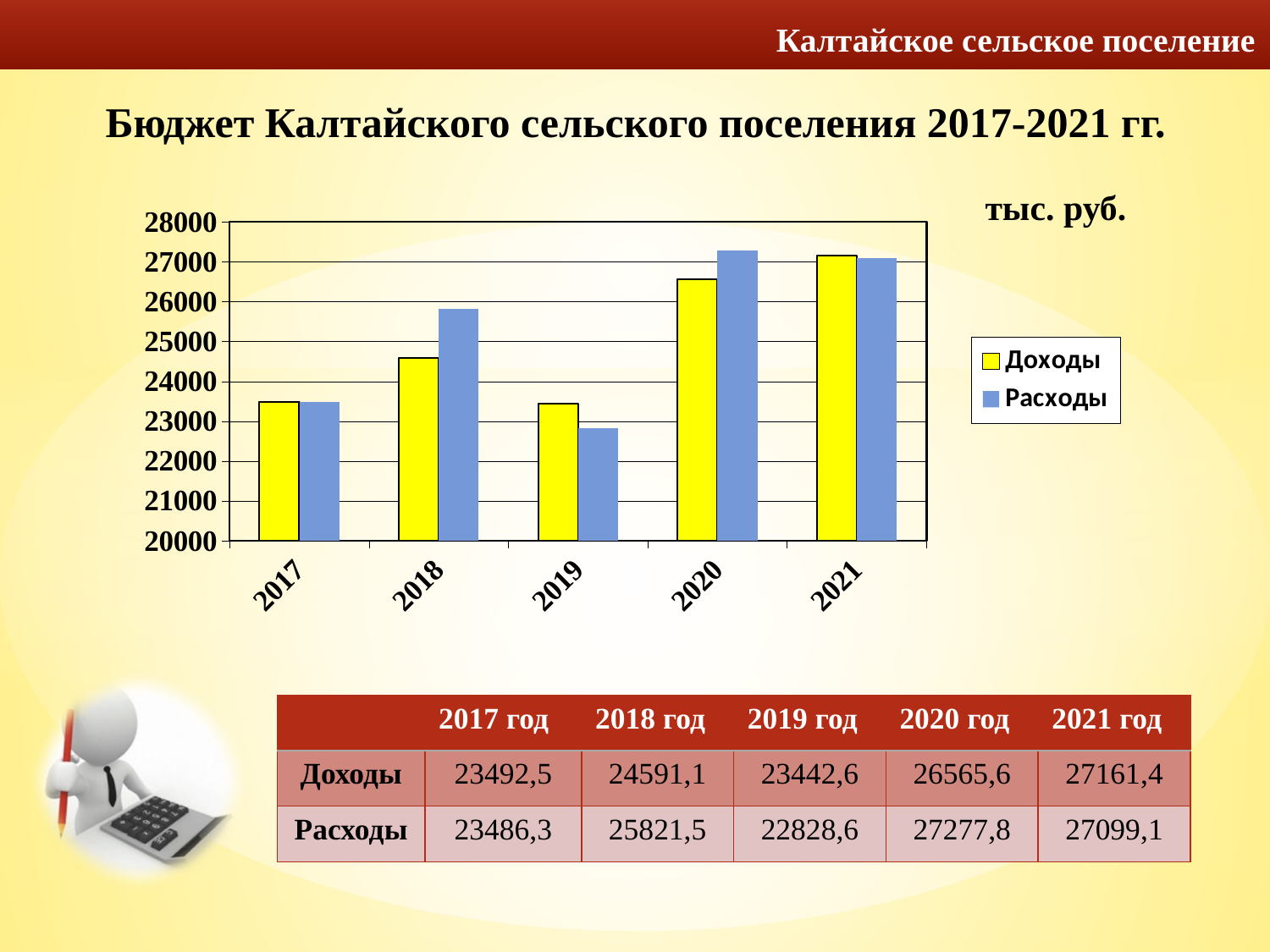
What is the difference between Расходы and Доходы in 2018? 1230,4 Which is larger in 2019, Доходы or Расходы? Доходы What is the value of Доходы for 2020? 26565,6 How many series does the legend list? 2 What is the value of Расходы for 2018? 25821,5 In which year is Расходы the highest? 2020 What is the difference between Расходы and Доходы in 2020? 712,2 In which year is Расходы the lowest? 2019 What kind of chart is shown on the slide? bar chart Is the value of Расходы for 2018 greater or less than 25000? greater In which year is Доходы the highest? 2021 How many years are shown on the x axis of the chart? 5